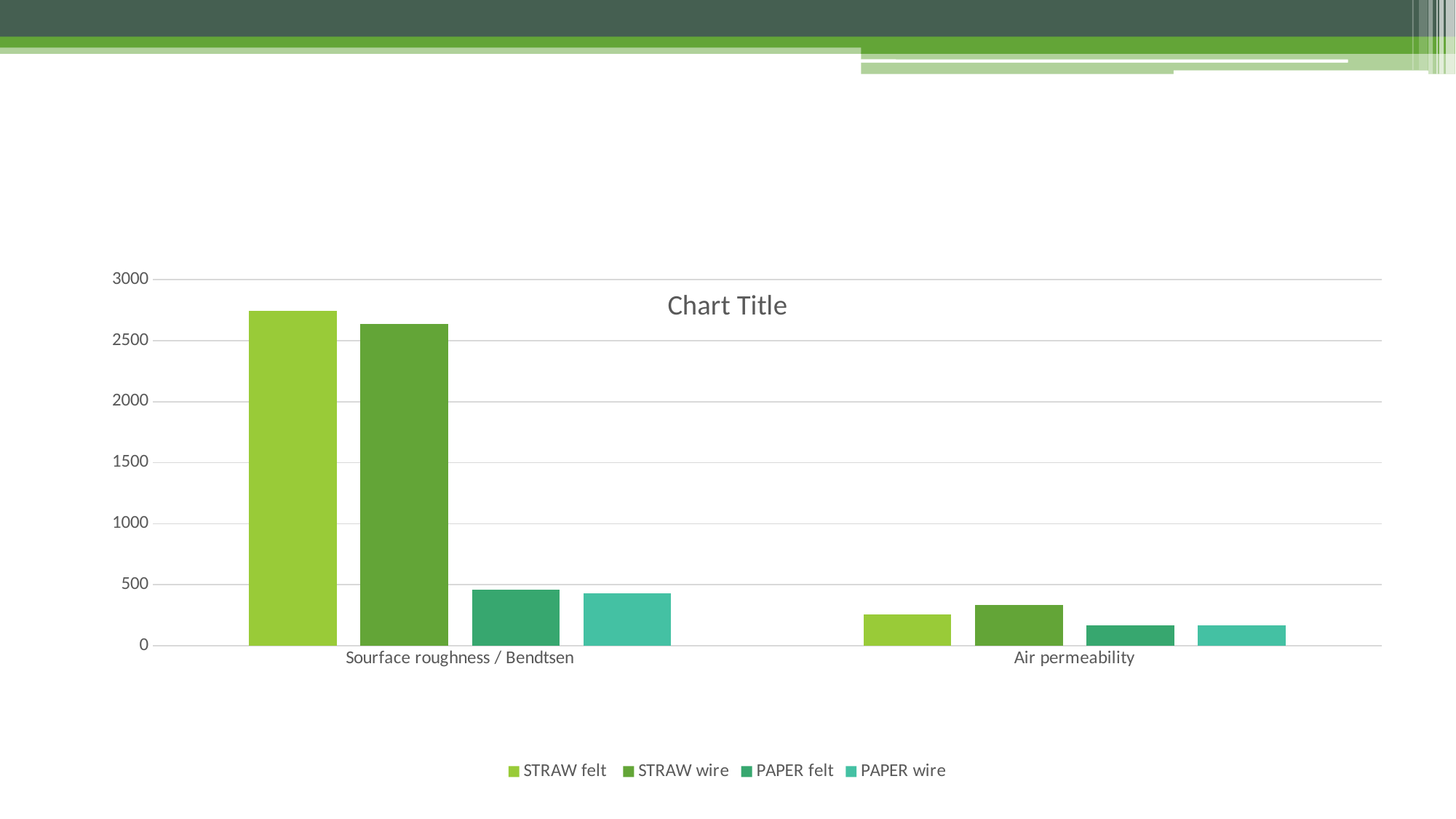
What kind of chart is shown on the slide? bar chart How many categories are shown on the x axis? 2 Which series has the highest value for Air permeability? STRAW wire Which series is shown in the lightest green colour in the legend? STRAW felt For Sourface roughness / Bendtsen, which is larger: STRAW felt or PAPER felt? STRAW felt Which series has the highest value for Sourface roughness / Bendtsen? STRAW felt What is the title of the chart? Chart Title Is the PAPER felt value for Sourface roughness / Bendtsen greater or less than 500? less How many series does the legend list? 4 Is the STRAW felt value for Sourface roughness / Bendtsen greater or less than 2500? greater For Air permeability, which is larger: STRAW wire or STRAW felt? STRAW wire Is the STRAW wire value for Air permeability greater or less than 500? less